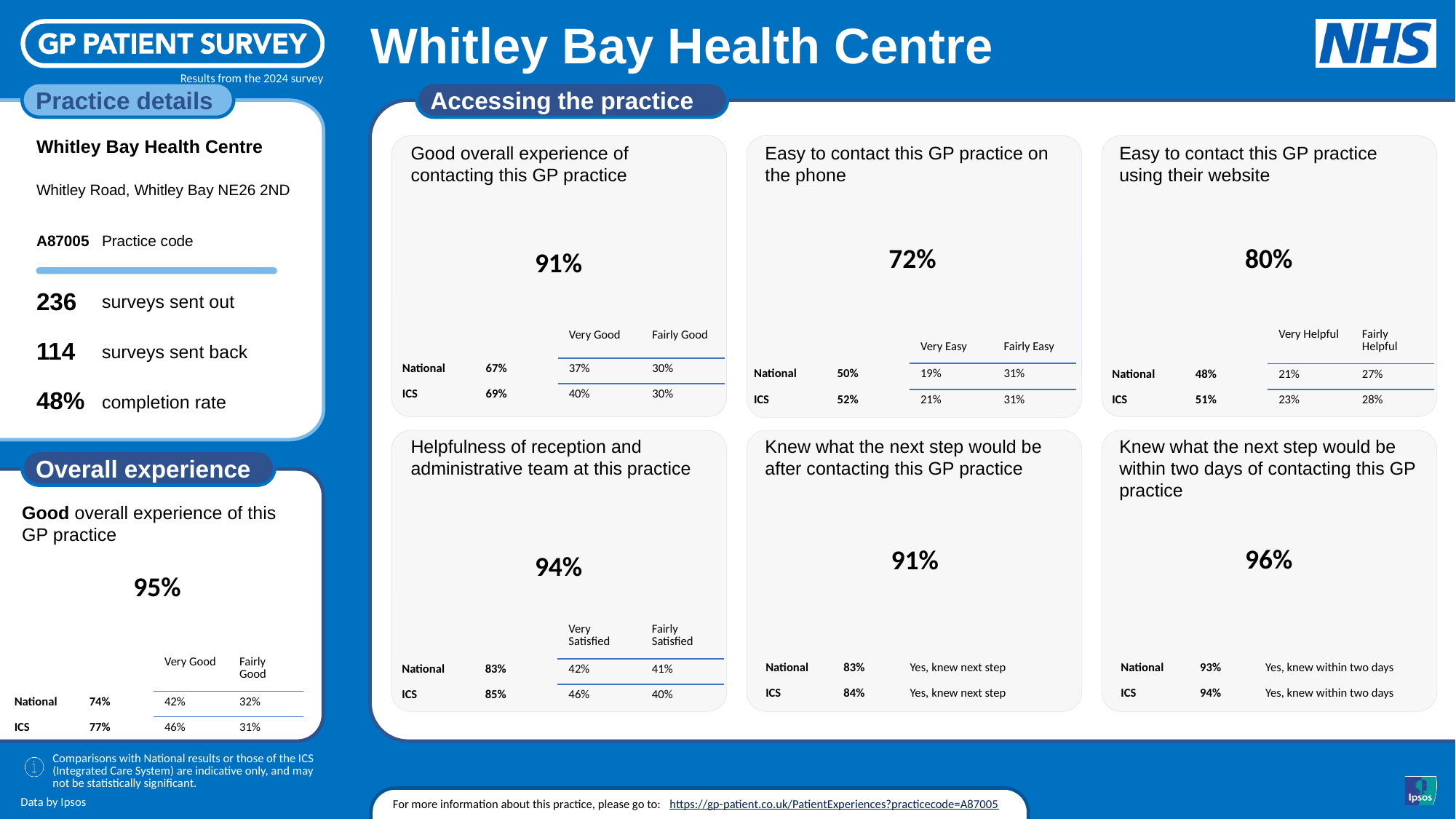
In the 'Helpfulness of reception and administrative team at this practice' panel, what is the National value for Fairly Satisfied? 41% In the 'Good overall experience of contacting this GP practice' panel, what is the practice's headline percentage? 91% How many panels are shown in the 'Accessing the practice' section? 6 Across the six 'Accessing the practice' panels, which measure has the highest practice percentage? Knew what the next step would be within two days of contacting this GP practice In the 'Good overall experience of this GP practice' panel, which is larger: the National value or the ICS value? ICS In the 'Knew what the next step would be within two days of contacting this GP practice' panel, what is the ICS value? 94% In the 'Easy to contact this GP practice on the phone' panel, what is the difference between the practice's 72% and the National 50%? 22 percentage points In the 'Easy to contact this GP practice on the phone' panel, what is the National value? 50% In the 'Knew what the next step would be after contacting this GP practice' panel, what is the difference between the ICS value and the National value? 1 percentage point In the 'Good overall experience of this GP practice' panel under Overall experience, what is the practice's headline percentage? 95% In the 'Easy to contact this GP practice using their website' panel, what is the ICS value for Very Helpful? 23% Across the six 'Accessing the practice' panels, which measure has the lowest practice percentage? Easy to contact this GP practice on the phone